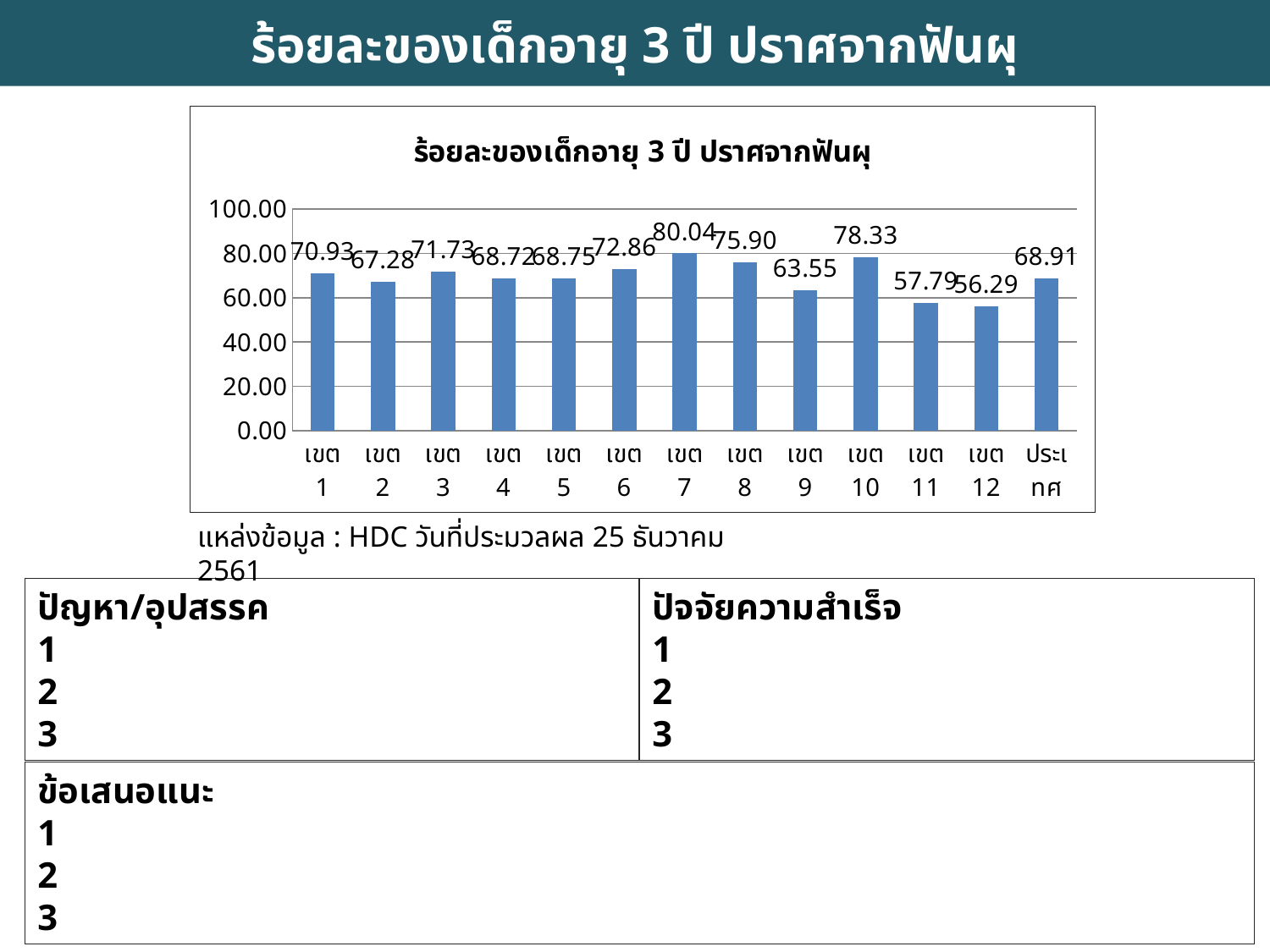
What kind of chart is shown on the slide? bar chart What is the title of the chart? ร้อยละของเด็กอายุ 3 ปี ปราศจากฟันผุ What is the difference between the values for เขต 7 and เขต 12? 23.75 How many categories are shown on the x axis? 13 Which category has the lowest value? เขต 12 What is the value for ประเทศ? 68.91 What is the value for เขต 7? 80.04 Which category has the highest value? เขต 7 What is the value for เขต 10? 78.33 Which is larger, the value for เขต 8 or the value for เขต 9? เขต 8 What is the value for เขต 12? 56.29 Is the value for เขต 11 greater or less than 60.00? less